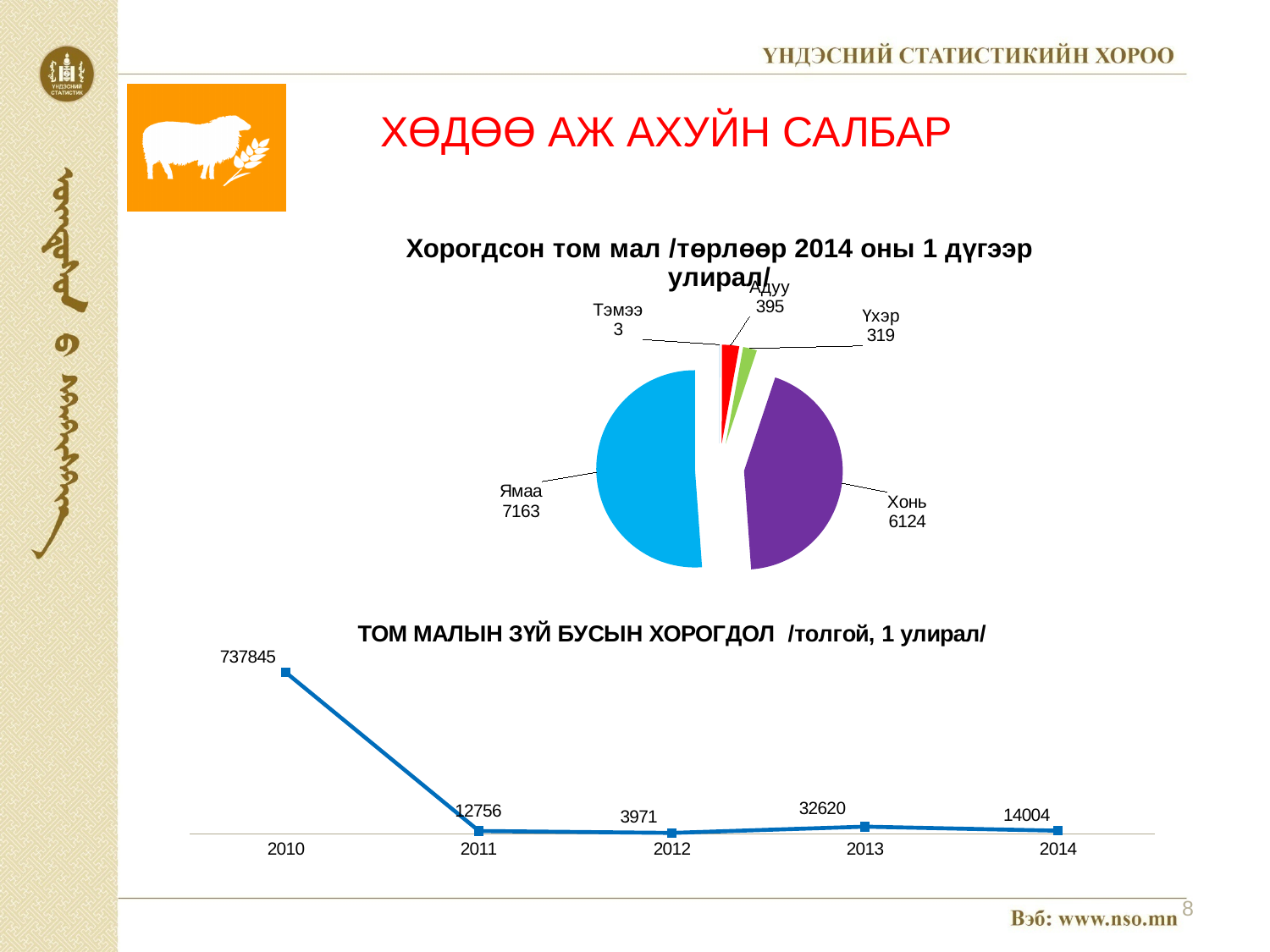
In the pie chart 'Хорогдсон том мал /төрлөөр 2014 оны 1 дүгээр улирал/', what is the difference between the values for Ямаа and Хонь? 1039 In the line chart 'ТОМ МАЛЫН ЗҮЙ БУСЫН ХОРОГДОЛ /толгой, 1 улирал/', what is the difference between the values for 2013 and 2014? 18616 In the pie chart 'Хорогдсон том мал /төрлөөр 2014 оны 1 дүгээр улирал/', which is larger, Адуу or Үхэр? Адуу In the pie chart 'Хорогдсон том мал /төрлөөр 2014 оны 1 дүгээр улирал/', what is the value for Үхэр? 319 In the pie chart 'Хорогдсон том мал /төрлөөр 2014 оны 1 дүгээр улирал/', how many categories are shown? 5 In the line chart 'ТОМ МАЛЫН ЗҮЙ БУСЫН ХОРОГДОЛ /толгой, 1 улирал/', what is the value for 2010? 737845 In the line chart 'ТОМ МАЛЫН ЗҮЙ БУСЫН ХОРОГДОЛ /толгой, 1 улирал/', which year has the lowest value? 2012 In the pie chart 'Хорогдсон том мал /төрлөөр 2014 оны 1 дүгээр улирал/', what is the value for Ямаа? 7163 In the pie chart 'Хорогдсон том мал /төрлөөр 2014 оны 1 дүгээр улирал/', which category has the smallest slice? Тэмээ In the pie chart 'Хорогдсон том мал /төрлөөр 2014 оны 1 дүгээр улирал/', which category has the largest slice? Ямаа What type of chart is the lower chart 'ТОМ МАЛЫН ЗҮЙ БУСЫН ХОРОГДОЛ /толгой, 1 улирал/'? line chart In the line chart 'ТОМ МАЛЫН ЗҮЙ БУСЫН ХОРОГДОЛ /толгой, 1 улирал/', how many data points are plotted? 5